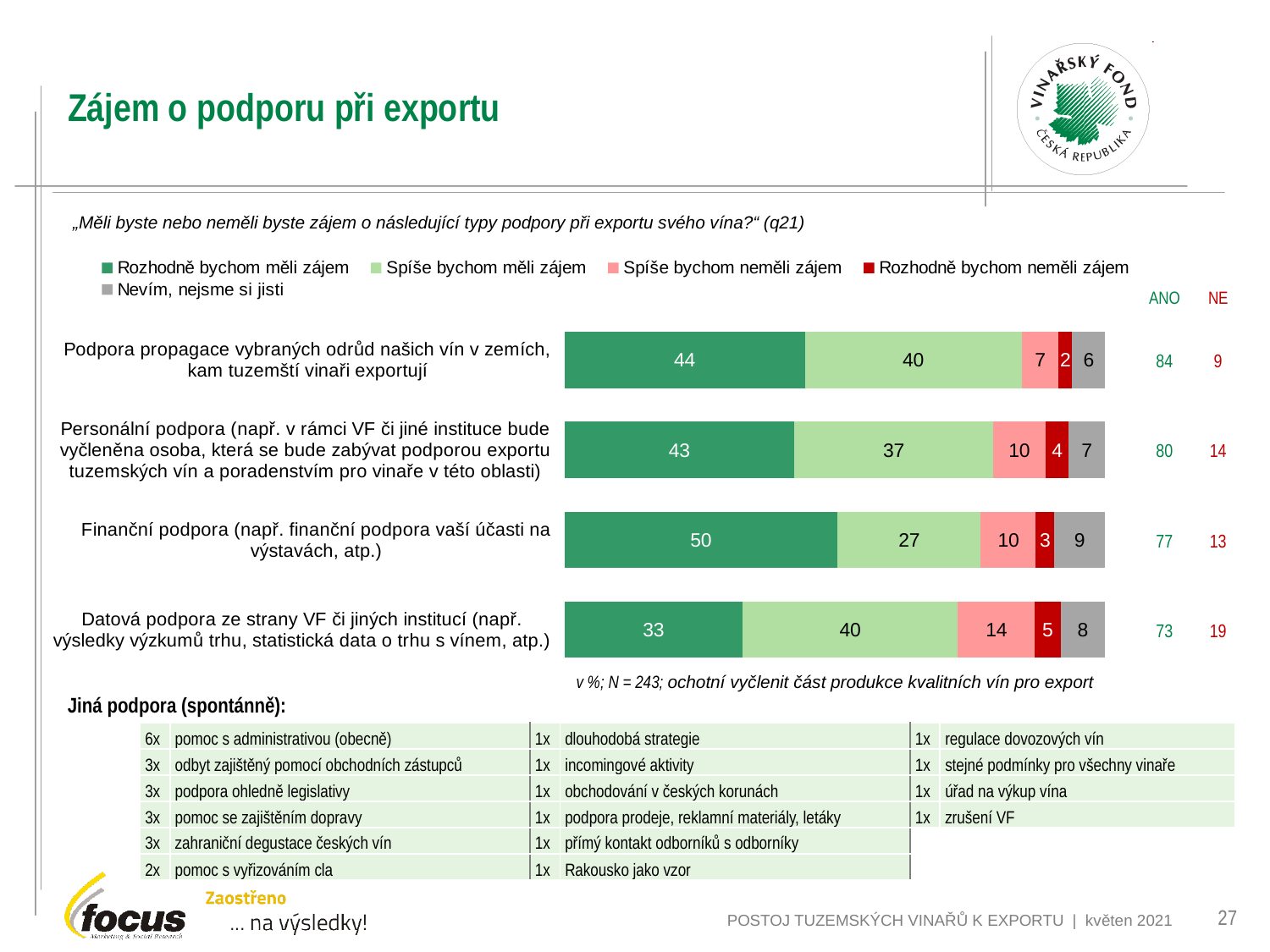
Which is larger: the "Spíše bychom neměli zájem" value for "Datová podpora" or for "Podpora propagace vybraných odrůd"? Datová podpora How many categories (types of support) are shown in the chart? 4 What is the value of "Rozhodně bychom měli zájem" for "Finanční podpora"? 50 How many series does the legend list? 5 What type of chart is shown on the slide? Stacked bar chart Which category has the lowest value for "Rozhodně bychom měli zájem"? Datová podpora ze strany VF či jiných institucí What is the combined value of "Rozhodně bychom měli zájem" and "Spíše bychom měli zájem" for "Podpora propagace vybraných odrůd našich vín"? 84 What is the NE value shown for "Personální podpora"? 14 What is the value of "Spíše bychom měli zájem" for "Personální podpora"? 37 What is the difference between the "Rozhodně bychom měli zájem" values for "Finanční podpora" and "Datová podpora"? 17 Which category has the highest value for "Rozhodně bychom měli zájem"? Finanční podpora What is the value of "Nevím, nejsme si jisti" for "Datová podpora ze strany VF či jiných institucí"? 8